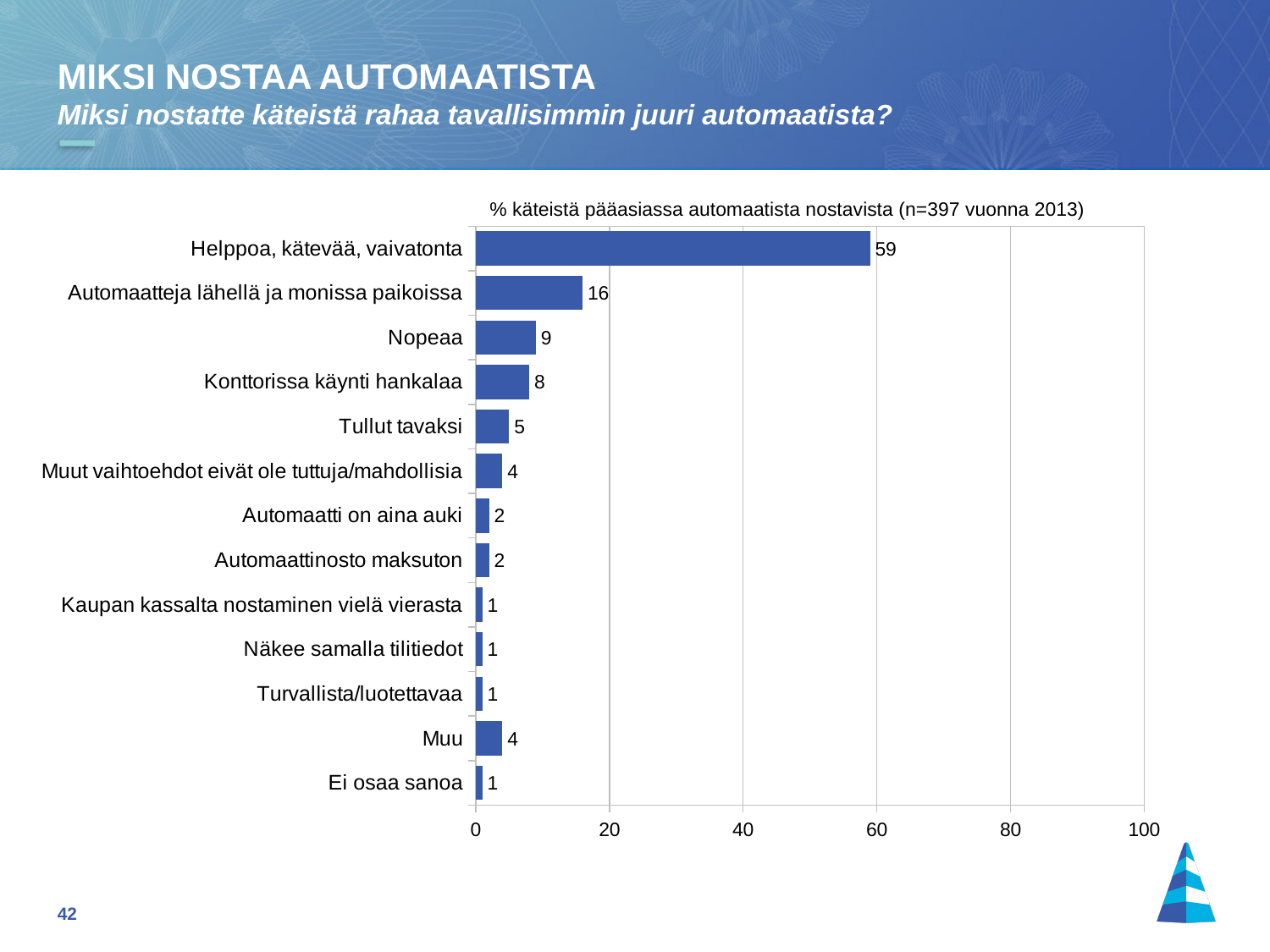
Is the value for "Helppoa, kätevää, vaivatonta" greater or less than 40? greater Which is larger, the value for "Nopeaa" or the value for "Konttorissa käynti hankalaa"? Nopeaa What is the value for "Konttorissa käynti hankalaa"? 8 What kind of chart is shown on the slide? Bar chart Which category has the highest value? Helppoa, kätevää, vaivatonta What is the value for "Muu"? 4 What is the difference between the values for "Nopeaa" and "Tullut tavaksi"? 4 What is the difference between the values for "Helppoa, kätevää, vaivatonta" and "Automaatteja lähellä ja monissa paikoissa"? 43 What is the title of the chart? % käteistä pääasiassa automaatista nostavista (n=397 vuonna 2013) What is the value for "Automaatteja lähellä ja monissa paikoissa"? 16 How many categories are shown in the chart? 13 What is the value for "Helppoa, kätevää, vaivatonta"? 59